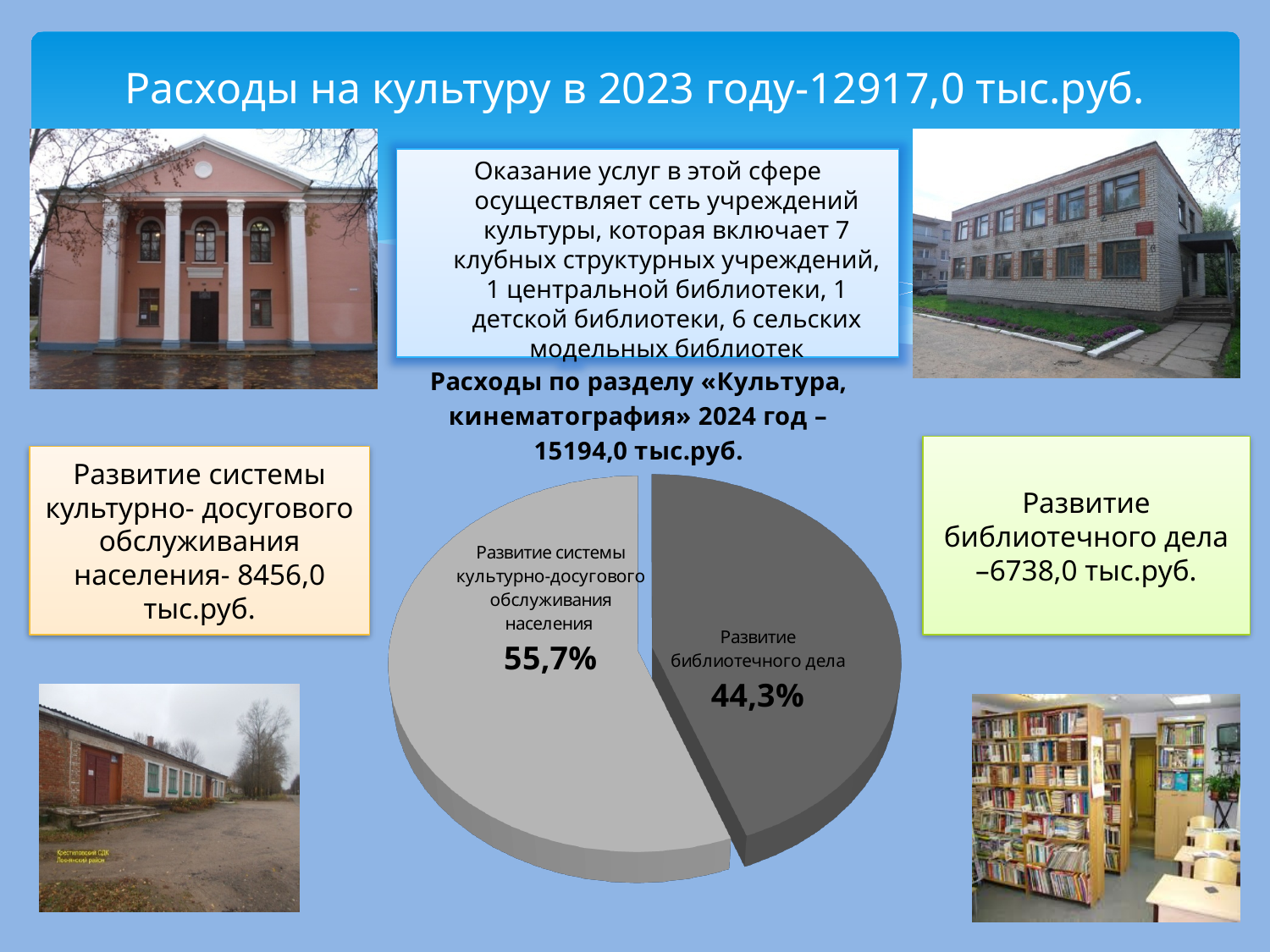
Which slice of the pie chart is the smallest? Развитие библиотечного дела What type of chart is shown on the slide? pie chart Is the share for «Развитие библиотечного дела» greater or less than 50%? less How many slices does the pie chart have? 2 Which slice of the pie chart is the largest? Развитие системы культурно-досугового обслуживания населения What colour is the «Развитие библиотечного дела» slice of the pie chart? dark grey What is the title of the pie chart? Расходы по разделу «Культура, кинематография» 2024 год – 15194,0 тыс.руб. What share of the pie chart is labelled «Развитие библиотечного дела»? 44,3% What share of the pie chart is labelled «Развитие системы культурно-досугового обслуживания населения»? 55,7% By how many percentage points does the «Развитие системы культурно-досугового обслуживания населения» slice exceed the «Развитие библиотечного дела» slice? 11,4 Which is larger in the pie chart: «Развитие библиотечного дела» or «Развитие системы культурно-досугового обслуживания населения»? Развитие системы культурно-досугового обслуживания населения